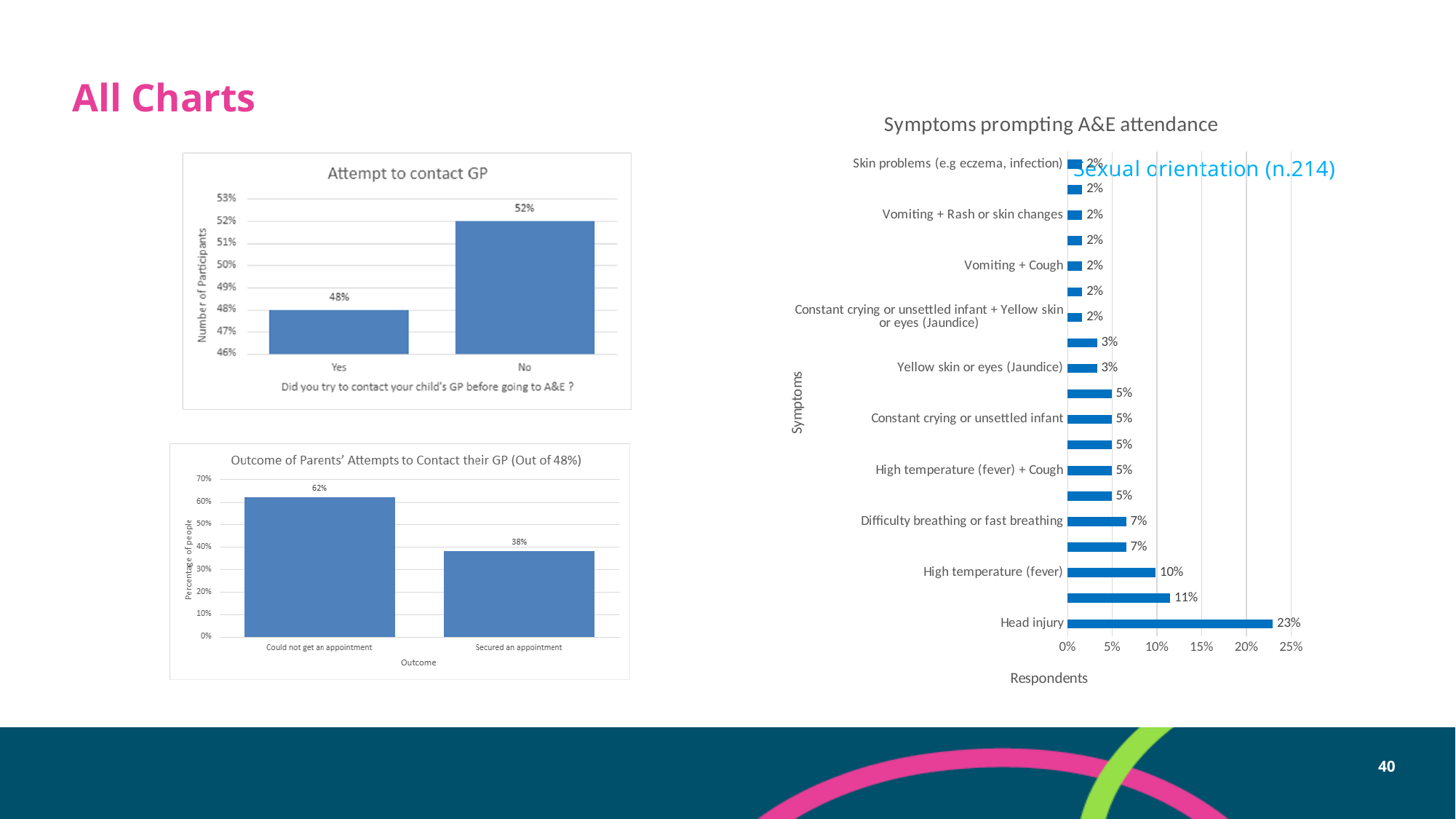
In the 'Attempt to contact GP' chart, which response has the higher value, Yes or No? No In the 'Outcome of Parents' Attempts to Contact their GP' chart, what is the difference between 'Could not get an appointment' and 'Secured an appointment'? 24 percentage points In the 'Attempt to contact GP' chart, what percentage of participants answered No? 52% In the 'Outcome of Parents' Attempts to Contact their GP' chart, what is the value for 'Secured an appointment'? 38% In the 'Outcome of Parents' Attempts to Contact their GP' chart, what is the value for 'Could not get an appointment'? 62% How many outcome categories are shown in the 'Outcome of Parents' Attempts to Contact their GP' chart? 2 What type of chart is the 'Symptoms prompting A&E attendance' chart? Bar chart In the 'Symptoms prompting A&E attendance' chart, what percentage of respondents is shown for High temperature (fever)? 10% In the 'Symptoms prompting A&E attendance' chart, what percentage of respondents is shown for Head injury? 23% In the 'Symptoms prompting A&E attendance' chart, which symptom has the highest percentage of respondents? Head injury In the 'Attempt to contact GP' chart, what is the difference between the No and Yes values? 4 percentage points In the 'Attempt to contact GP' chart, what percentage of participants answered Yes? 48%